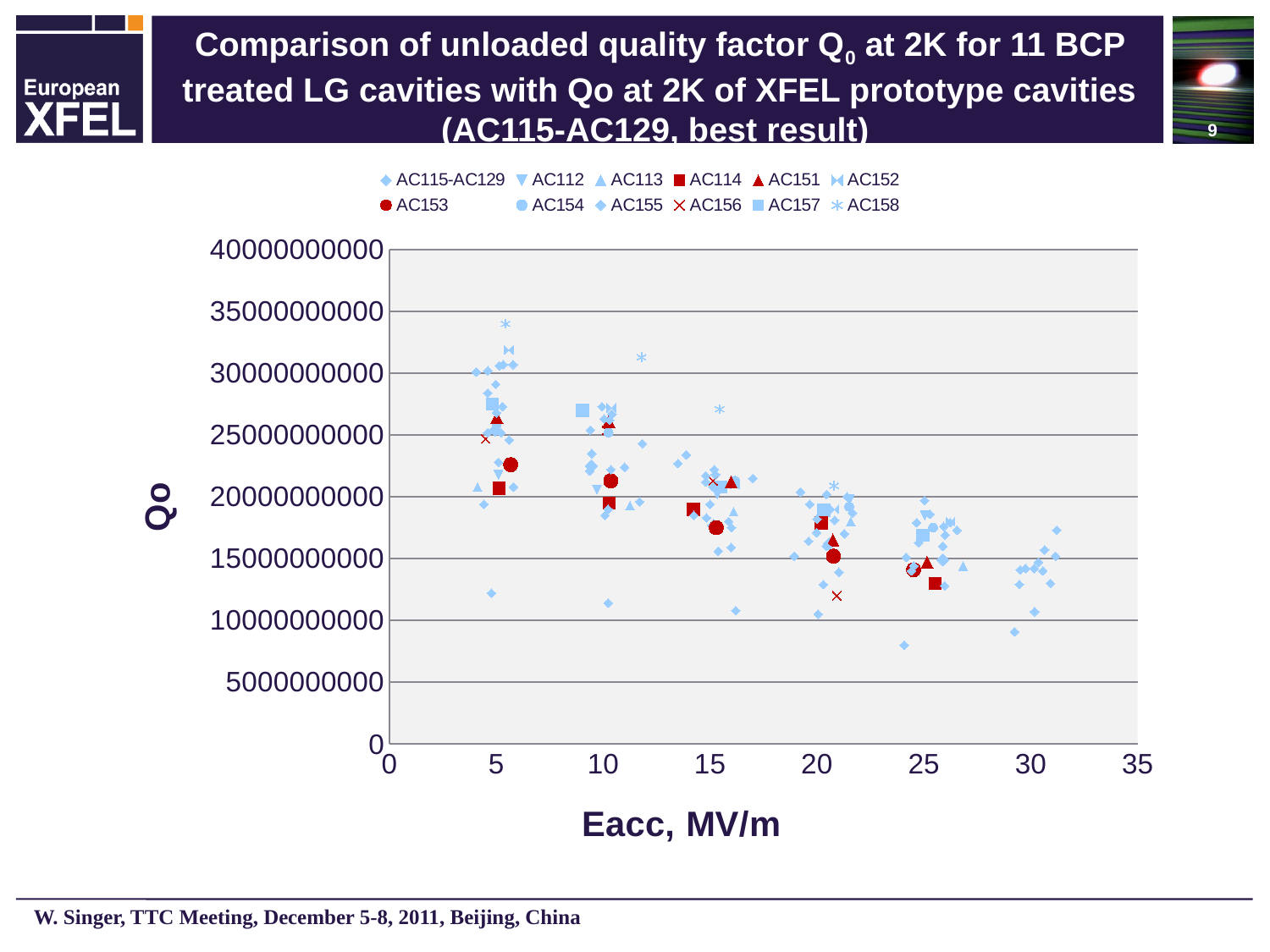
Is the AC114 value plotted near Eacc 25 greater or less than 15000000000? less What is the highest tick value shown on the y axis? 40000000000 Is the AC153 value plotted near Eacc 25 greater or less than 15000000000? less Is the highest plotted Qo value on the chart greater or less than 30000000000? greater Do the Qo values generally rise or fall as Eacc increases along the x axis? fall What kind of chart is shown on the slide? scatter chart What is the label of the x axis? Eacc, MV/m What is the label of the y axis? Qo How many series does the legend list? 12